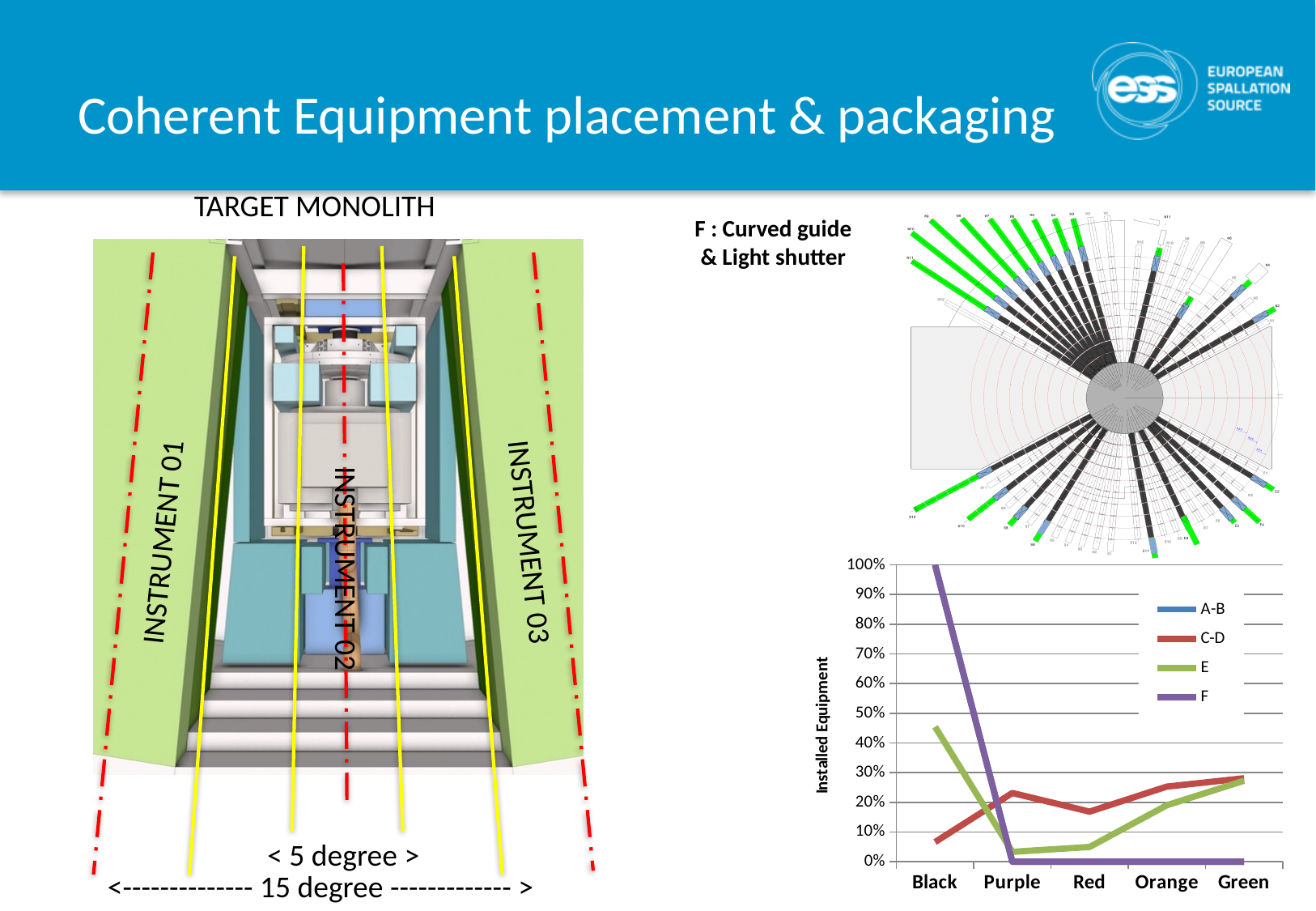
In the line chart, which series has the larger value for Black, C-D or E? E In the line chart, what is the value of series F for Black? 100% In the line chart, what is the value of series F for Green? 0% In the line chart, is the value of series C-D for Purple greater or less than 30%? less In the line chart, which series has the larger value for Red, C-D or E? C-D In the line chart, is the value of series C-D for Black greater or less than 10%? less In the line chart, for which category is series F highest? Black How many categories are shown on the x axis of the line chart? 5 How many series does the legend of the line chart list? 4 What kind of chart is shown at the bottom right of the slide? line chart What is the title of the vertical axis of the line chart? Installed Equipment In the line chart, is the value of series E for Black greater or less than 40%? greater